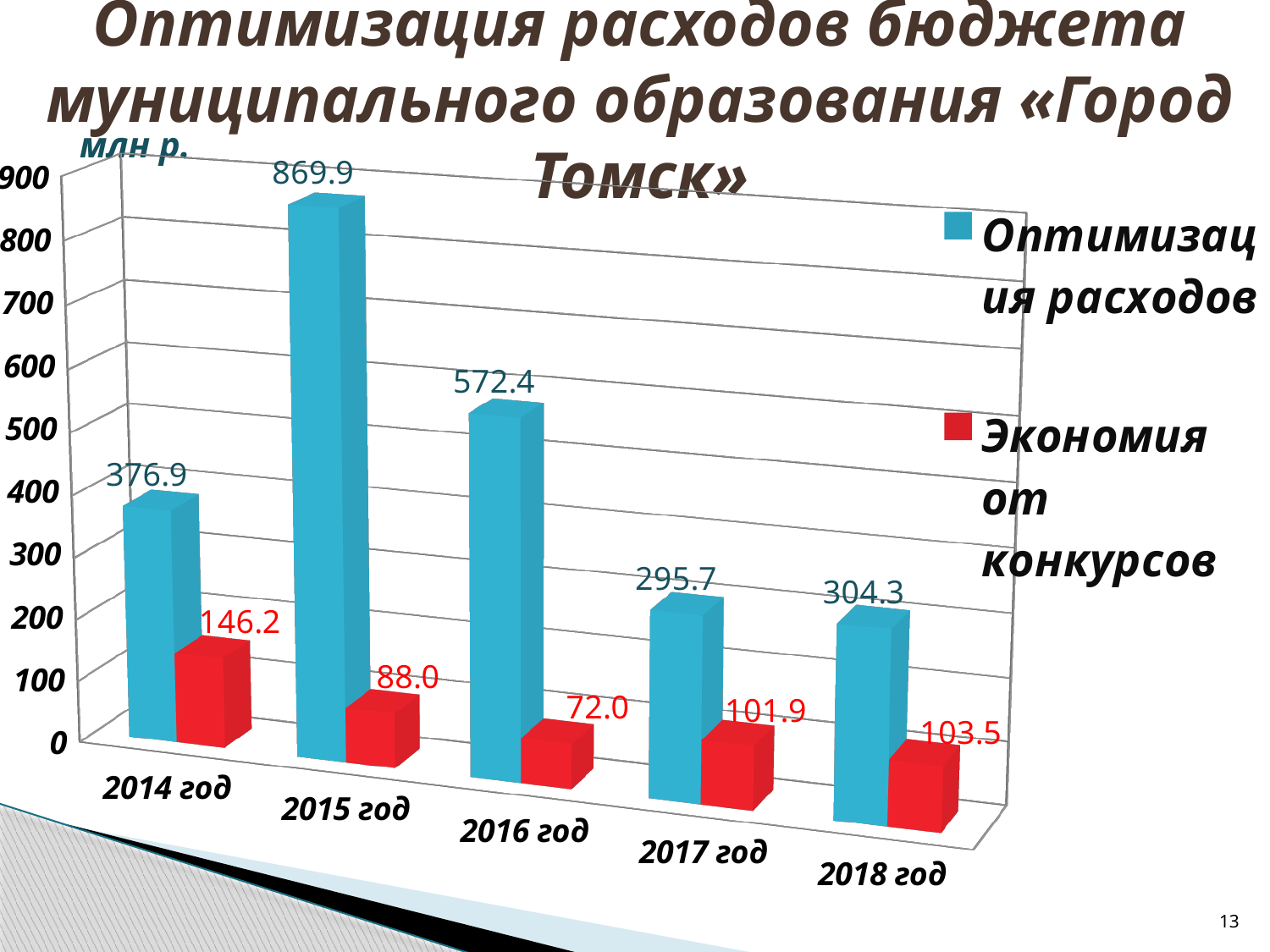
What is the value of «Оптимизация расходов» for 2015 год? 869.9 Which year has the highest value for «Оптимизация расходов»? 2015 год Is the value of «Оптимизация расходов» for 2014 год greater or less than 300? greater Which year has the lowest value for «Экономия от конкурсов»? 2016 год Which is larger: «Экономия от конкурсов» in 2017 год or in 2018 год? 2018 год What is the value of «Экономия от конкурсов» for 2016 год? 72.0 How many series does the legend list? 2 What unit is indicated at the top of the vertical axis? млн р. What is the value of «Экономия от конкурсов» for 2014 год? 146.2 What is the difference between «Оптимизация расходов» in 2015 год and 2016 год? 297.5 How many years are shown on the x axis? 5 What kind of chart is shown on the slide? bar chart